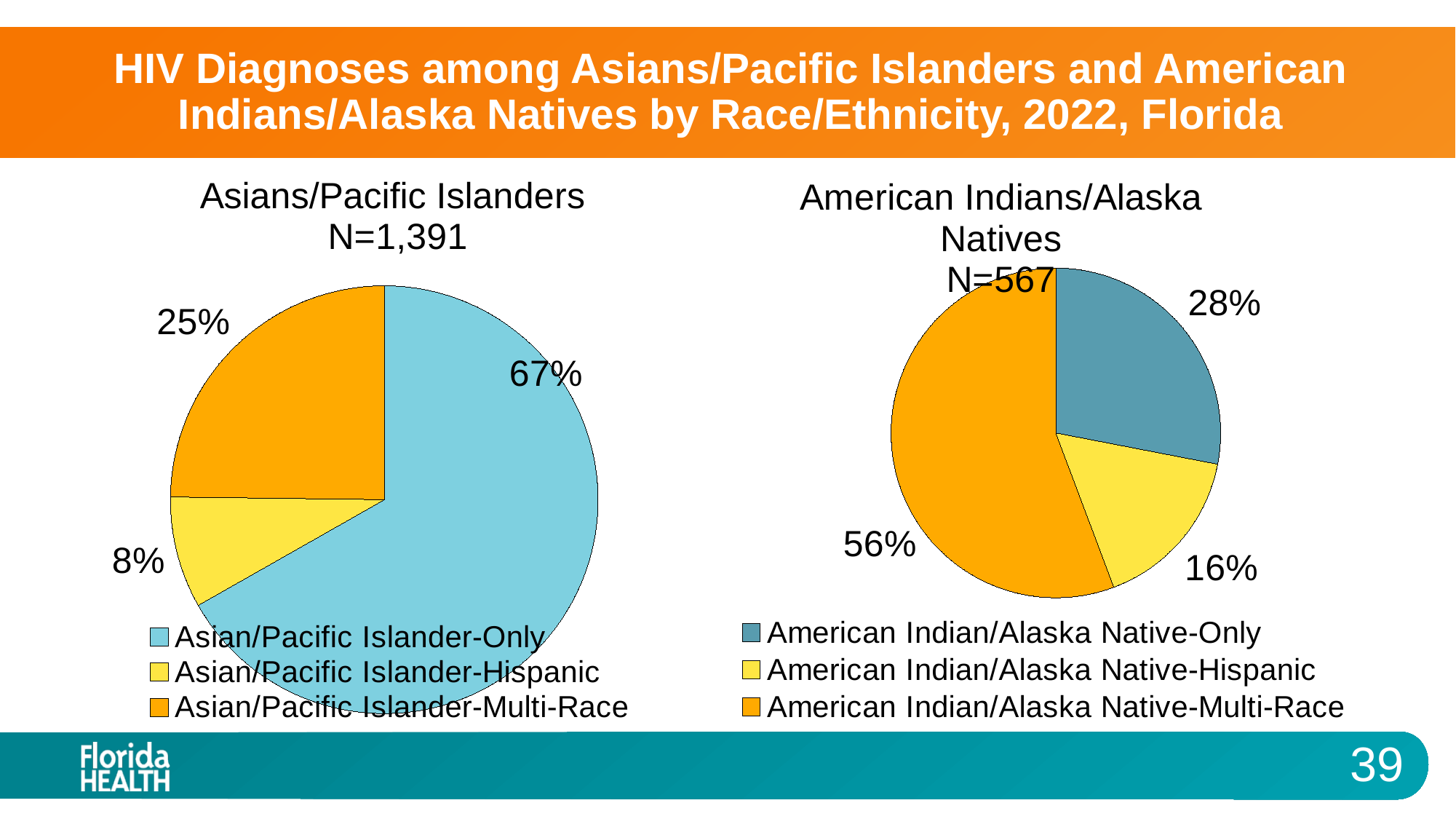
In the Asians/Pacific Islanders pie chart, what share of HIV diagnoses is Asian/Pacific Islander-Only? 67% In the Asians/Pacific Islanders pie chart, what share is Asian/Pacific Islander-Multi-Race? 25% In the American Indians/Alaska Natives pie chart, what share is American Indian/Alaska Native-Only? 28% In the American Indians/Alaska Natives pie chart, what share is American Indian/Alaska Native-Multi-Race? 56% In the American Indians/Alaska Natives pie chart, what is the difference between the Multi-Race share and the Only share? 28% What is the N value shown for the Asians/Pacific Islanders pie chart? N=1,391 What type of chart is used for the Asians/Pacific Islanders data? Pie chart In the Asians/Pacific Islanders pie chart, what share is Asian/Pacific Islander-Hispanic? 8% In the American Indians/Alaska Natives pie chart, which category has the largest share? American Indian/Alaska Native-Multi-Race In the Asians/Pacific Islanders pie chart, which is larger: the Multi-Race share or the Hispanic share? Asian/Pacific Islander-Multi-Race How many slices does the American Indians/Alaska Natives pie chart have? 3 In the Asians/Pacific Islanders pie chart, which category has the smallest share? Asian/Pacific Islander-Hispanic